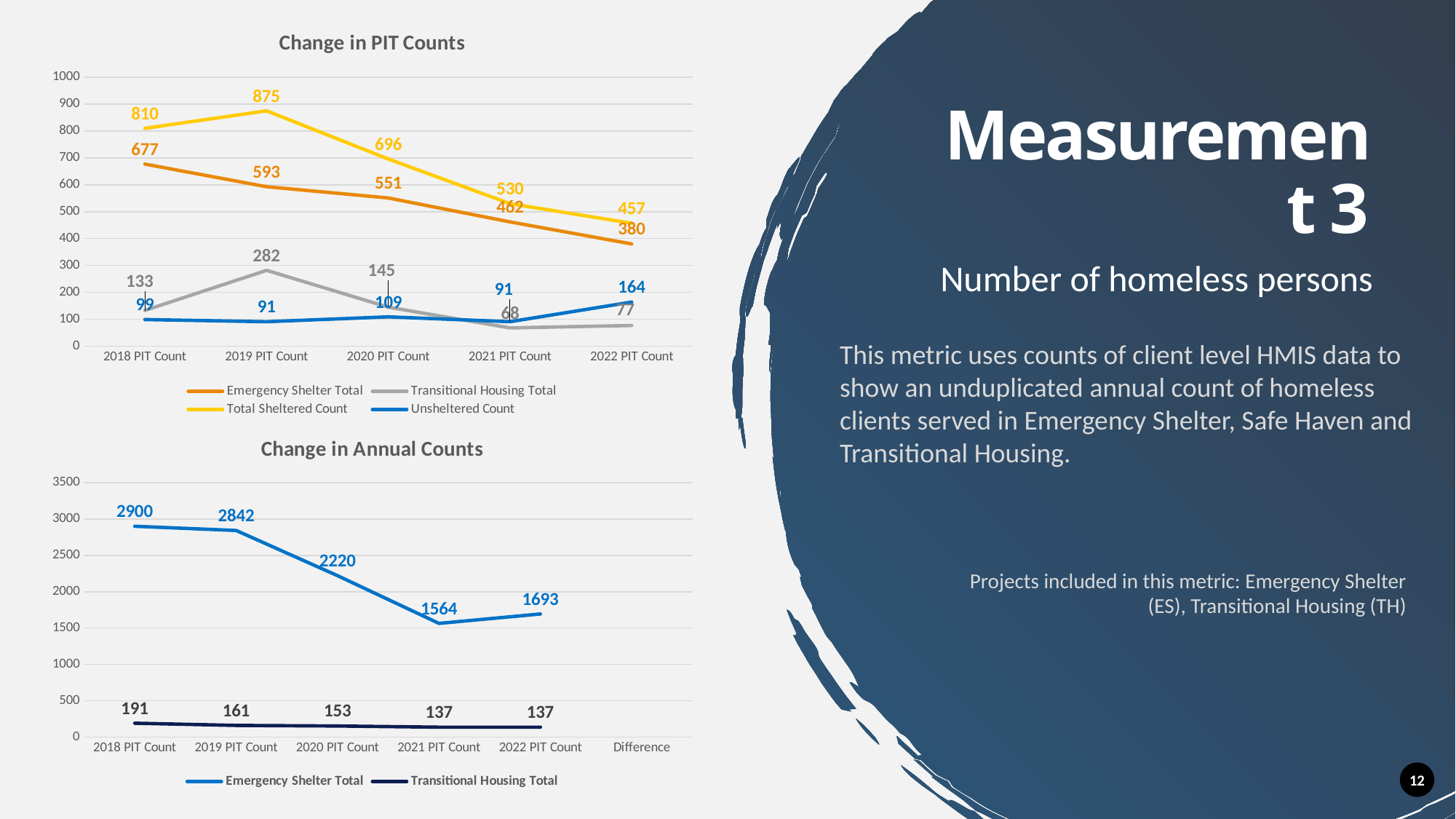
In the 'Change in PIT Counts' chart, in which PIT Count year is the Transitional Housing Total highest? 2019 PIT Count In the 'Change in Annual Counts' chart, what is the difference between the Emergency Shelter Total in 2018 and in 2019? 58 In the 'Change in PIT Counts' chart, what is the Emergency Shelter Total for the 2022 PIT Count? 380 In the 'Change in Annual Counts' chart, which is larger: the Emergency Shelter Total in 2021 or in 2022? 2022 In the 'Change in Annual Counts' chart, what is the Emergency Shelter Total for the 2021 PIT Count? 1564 In the 'Change in Annual Counts' chart, what is the Transitional Housing Total for the 2018 PIT Count? 191 In the 'Change in PIT Counts' chart, does the Emergency Shelter Total rise or fall from the 2018 PIT Count to the 2022 PIT Count? fall What type of chart is the 'Change in Annual Counts' chart? line chart In the 'Change in PIT Counts' chart, what is the difference between the Total Sheltered Count in 2018 and in 2022? 353 In the 'Change in PIT Counts' chart, how many series does the legend list? 4 In the 'Change in PIT Counts' chart, in which PIT Count year is the Unsheltered Count lowest? 2019 PIT Count and 2021 PIT Count (both 91) In the 'Change in PIT Counts' chart, what is the Total Sheltered Count for the 2019 PIT Count? 875